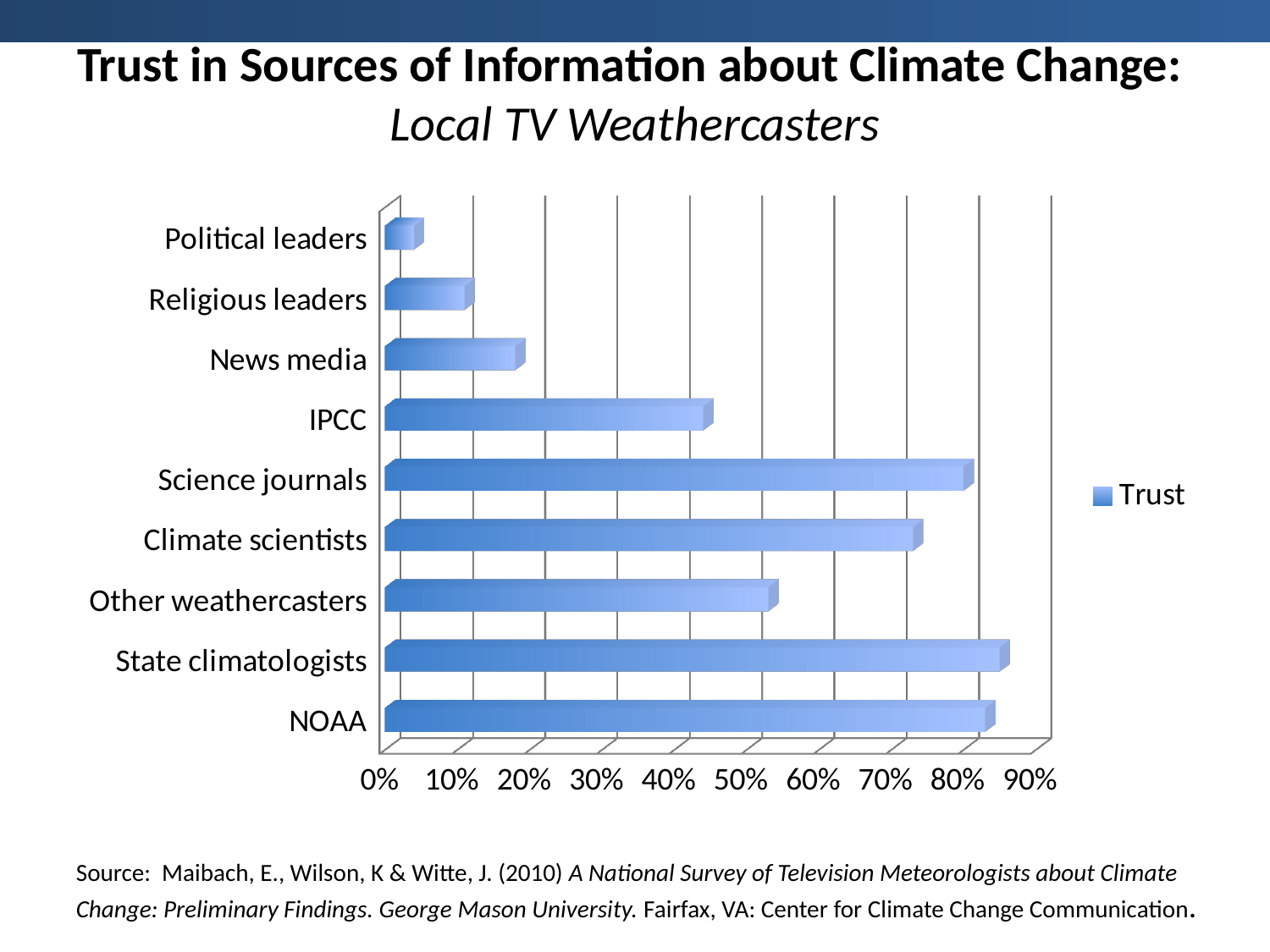
Is the value for IPCC greater or less than 40%? greater How many series does the legend list? 1 Is the value for Science journals greater or less than 70%? greater Is the value for News media greater or less than 20%? less Which source has the lowest trust value? Political leaders Which has a higher trust value, Science journals or Climate scientists? Science journals Which has a higher trust value, IPCC or Other weathercasters? Other weathercasters How many categories (sources of information) are plotted on the chart? 9 What kind of chart is shown on the slide? bar chart What is the name of the series shown in the legend? Trust